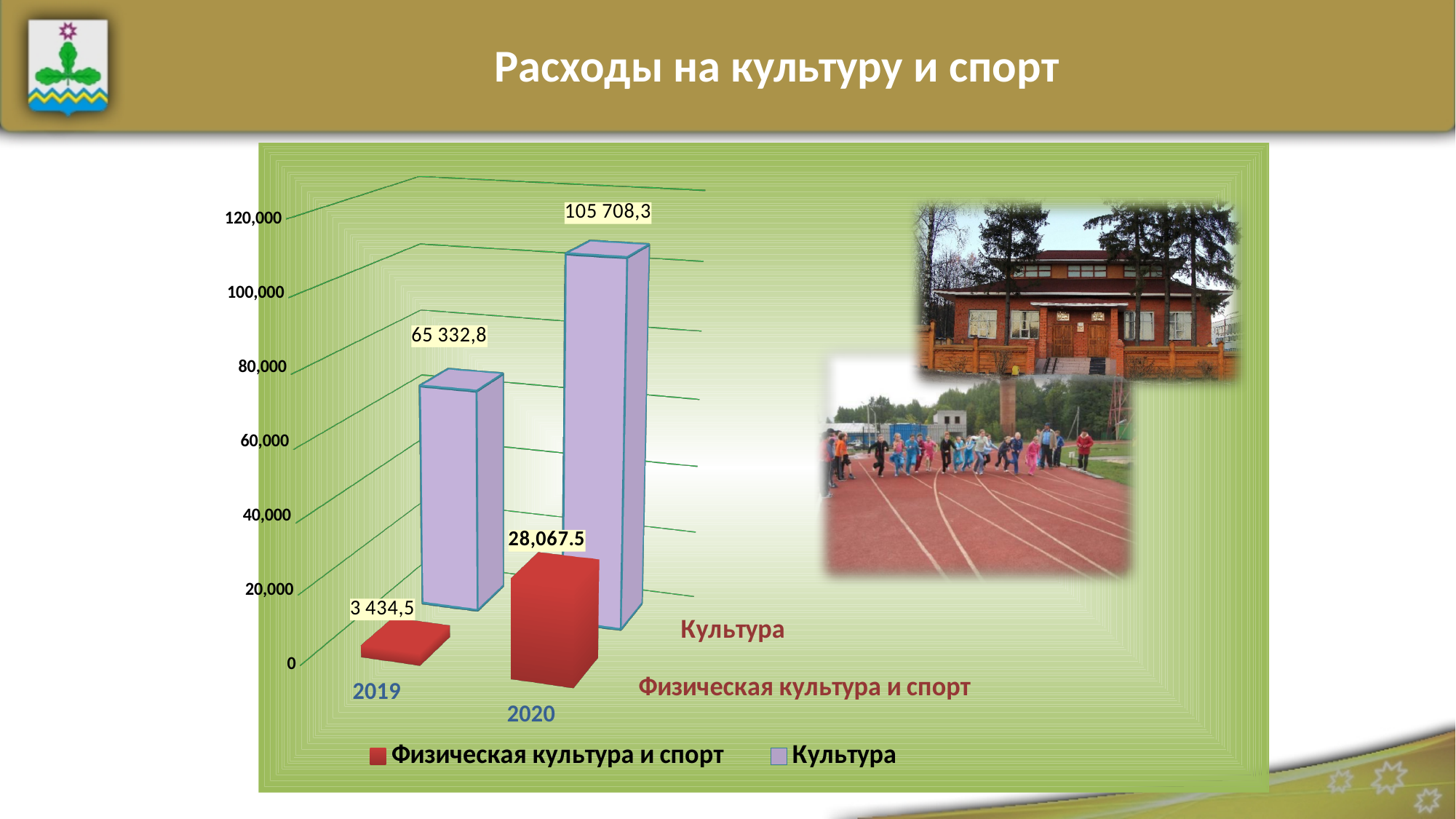
What is the title of the slide? Расходы на культуру и спорт How many series does the legend list? 2 What is the value for Культура in 2020? 105 708,3 What kind of chart is shown on the slide? Bar chart What is the value for Культура in 2019? 65 332,8 Which year has the higher value for Культура? 2020 Which is larger in 2020: Культура or Физическая культура и спорт? Культура Which bar on the chart has the lowest value? Физическая культура и спорт, 2019 What is the value for Физическая культура и спорт in 2019? 3 434,5 By how much did the value for Культура increase from 2019 to 2020? 40 375,5 What is the value for Физическая культура и спорт in 2020? 28,067.5 Is the value for Культура in 2020 greater or less than 100,000? greater